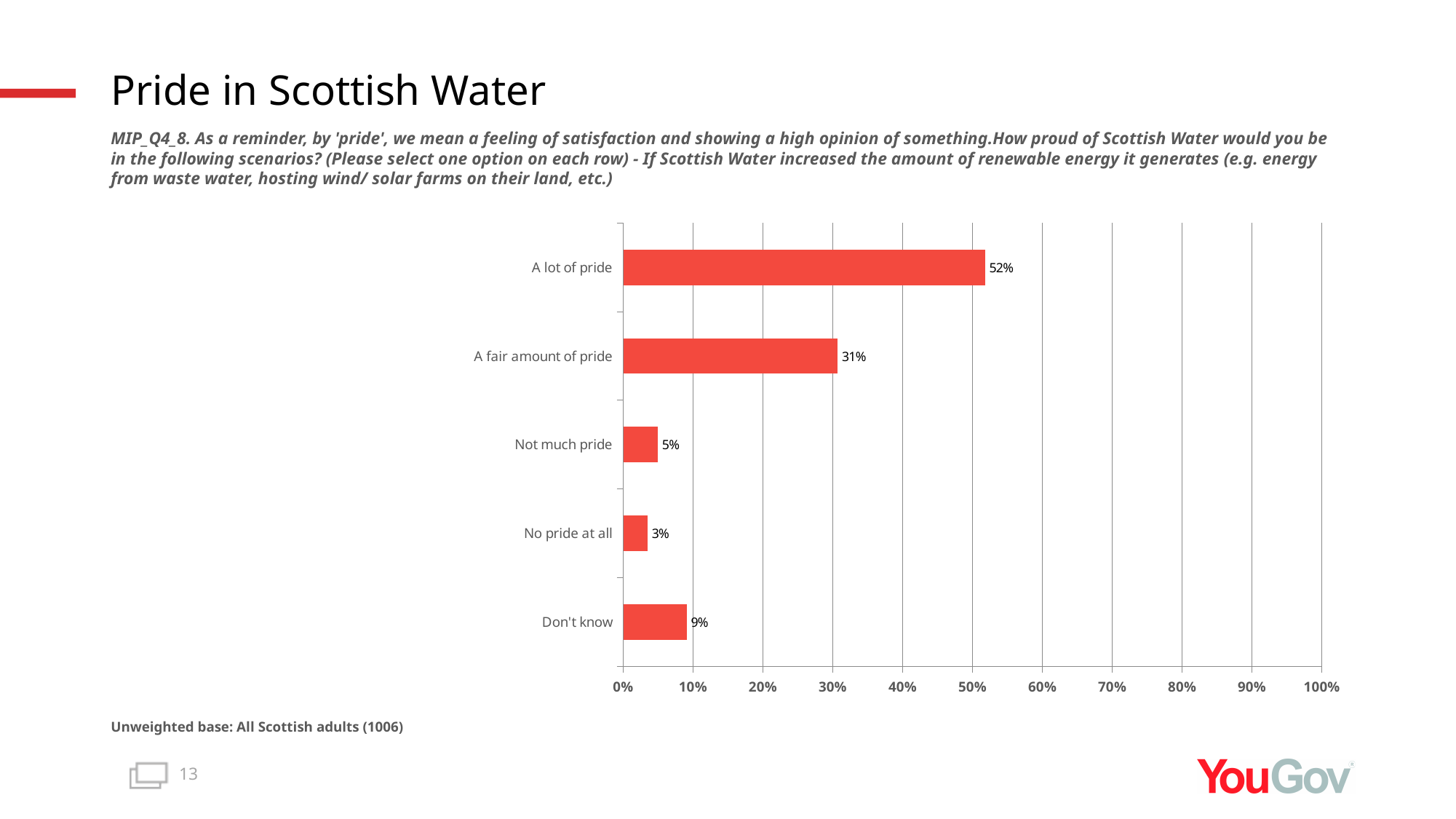
Which is larger, 'Not much pride' or 'Don't know'? Don't know What percentage answered 'Don't know'? 9% Which category has the highest value? A lot of pride What is the difference between 'A lot of pride' and 'A fair amount of pride'? 21% How many categories are shown in the chart? 5 What is the value for 'No pride at all'? 3% What is the combined value of 'Not much pride' and 'No pride at all'? 8% What kind of chart is shown on the slide? Bar chart What percentage of respondents said they would feel 'A lot of pride'? 52% Which category has the lowest value? No pride at all Is the value for 'A lot of pride' greater or less than 50%? greater What is the value for 'A fair amount of pride'? 31%